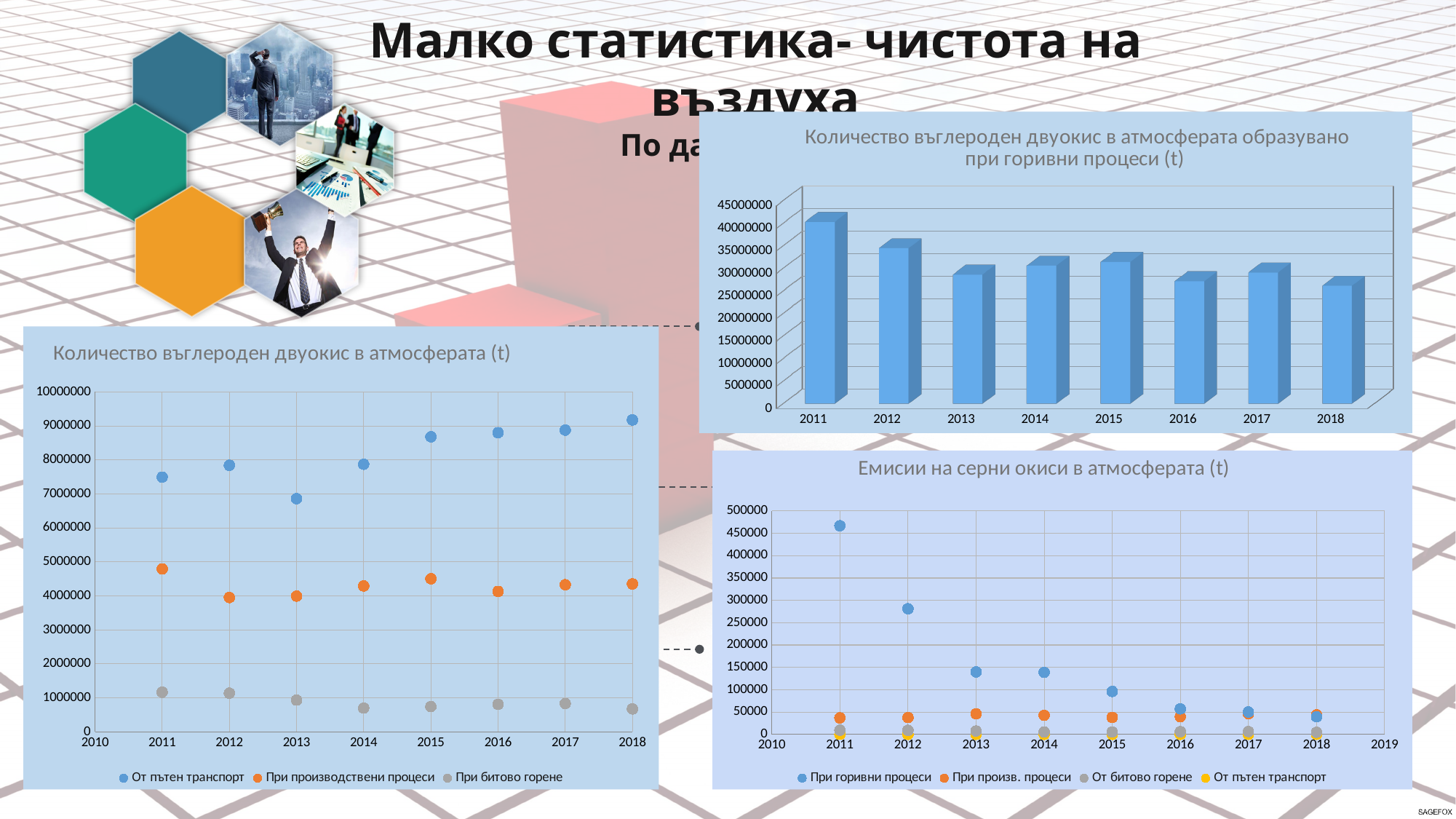
What kind of chart is the chart titled "Количество въглероден двуокис в атмосферата образувано при горивни процеси (t)"? bar chart In the chart titled "Количество въглероден двуокис в атмосферата образувано при горивни процеси (t)", how many bars are plotted? 8 In the chart titled "Количество въглероден двуокис в атмосферата (t)", is the value for От пътен транспорт in 2011 greater or less than 7000000? greater In the chart titled "Емисии на серни окиси в атмосферата (t)", how many series does the legend list? 4 In the chart titled "Емисии на серни окиси в атмосферата (t)", is the value for При горивни процеси in 2012 greater or less than 300000? less In the chart titled "Количество въглероден двуокис в атмосферата (t)", how many series does the legend list? 3 In the chart titled "Количество въглероден двуокис в атмосферата образувано при горивни процеси (t)", is the value for 2011 greater or less than 35000000? greater In the chart titled "Емисии на серни окиси в атмосферата (t)", do the values for При горивни процеси rise or fall from 2011 to 2018? fall In the chart titled "Количество въглероден двуокис в атмосферата образувано при горивни процеси (t)", which year has the highest value? 2011 In the chart titled "Количество въглероден двуокис в атмосферата (t)", in which year is the value for От пътен транспорт highest? 2018 In the chart titled "Количество въглероден двуокис в атмосферата образувано при горивни процеси (t)", which is larger, the value for 2012 or the value for 2013? 2012